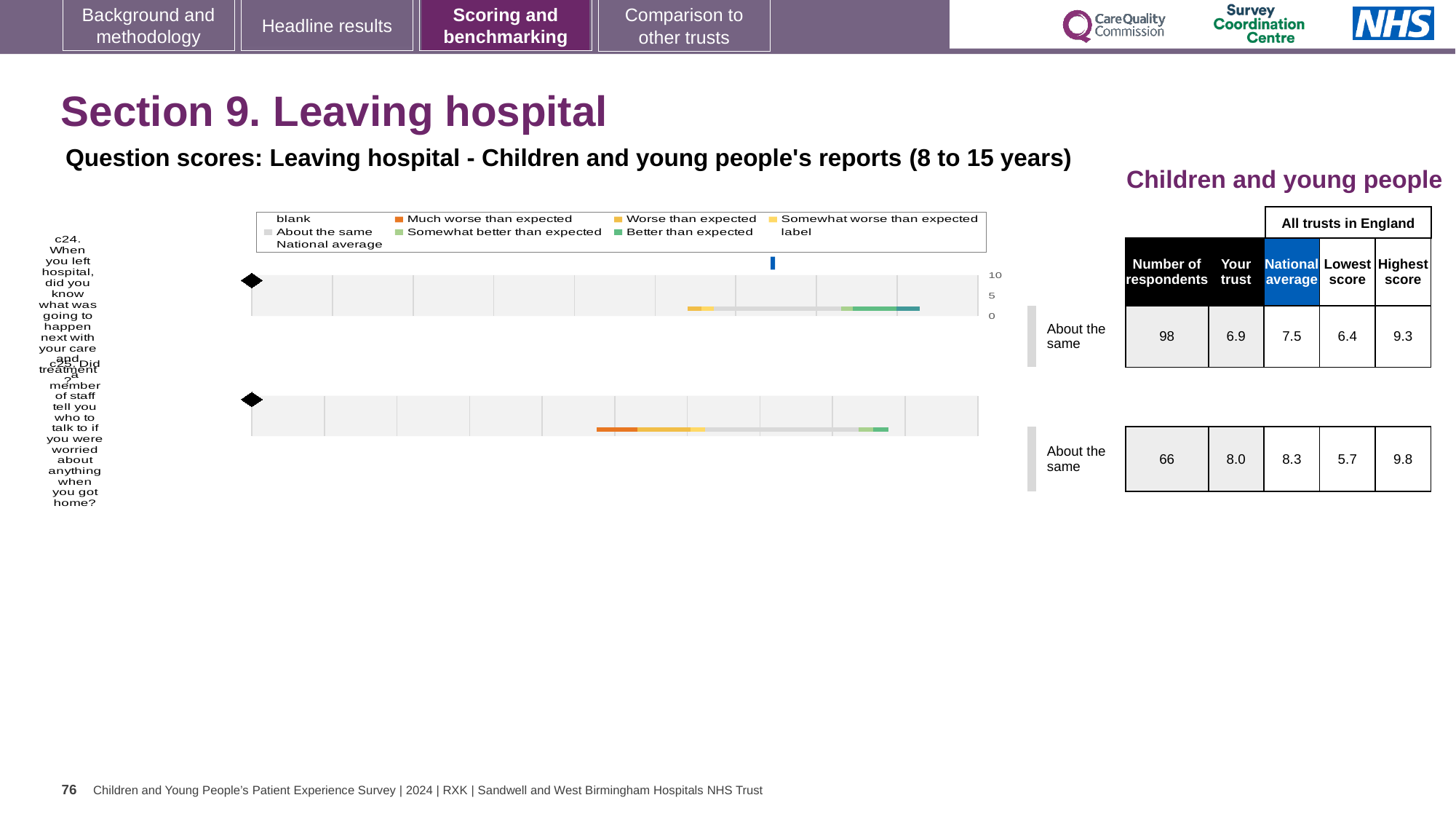
What is the national average score for question c25 (Did a member of staff tell you who to talk to if you were worried about anything when you got home?)? 8.3 What is the 'Your trust' score for question c24 (When you left hospital, did you know what was going to happen next with your care and treatment?)? 6.9 What is the lowest score among all trusts in England for question c25? 5.7 What is the difference between the national average and the 'Your trust' score for question c25? 0.3 How many questions (bars) are plotted in the chart? 2 How many respondents answered question c24? 98 Which question has the higher 'Your trust' score, c24 or c25? c25 What is the difference between the highest and lowest scores for question c24? 2.9 What is the highest score among all trusts in England for question c24? 9.3 What kind of chart is used to show the question scores for c24 and c25? bar chart Is the 'Your trust' score for question c24 greater or less than 5? greater What colour does the legend use for 'Much worse than expected'? orange